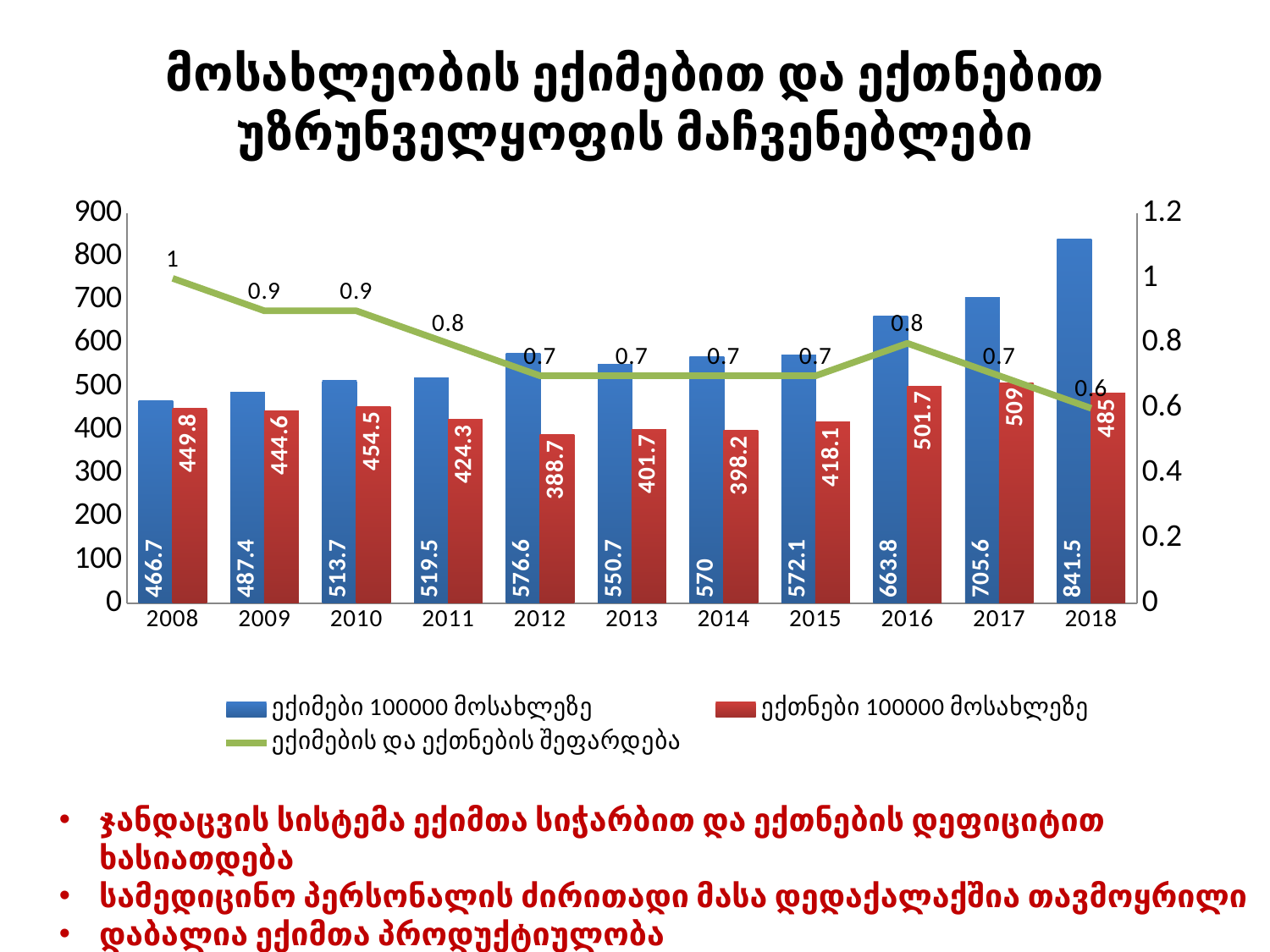
What is the value of the green line for 2016? 0.8 What is the difference between the blue and red bar values in 2018? 356.5 How many series does the legend list? 3 What is the value of the red series (ექთნები 100000 მოსახლეზე) for 2012? 388.7 How many years are shown on the x axis? 11 Which is larger in 2009: the blue bar (ექიმები) or the red bar (ექთნები)? the blue bar (ექიმები) What kind of chart is this? a combined bar and line chart In which year is the red series (ექთნები 100000 მოსახლეზე) lowest? 2012 In which year is the blue series (ექიმები 100000 მოსახლეზე) highest? 2018 Does the green line (ექიმების და ექთნების შეფარდება) generally rise or fall from 2008 to 2018? fall What is the value of the blue series (ექიმები 100000 მოსახლეზე) for 2018? 841.5 What is the value of the green line (ექიმების და ექთნების შეფარდება) for 2008? 1